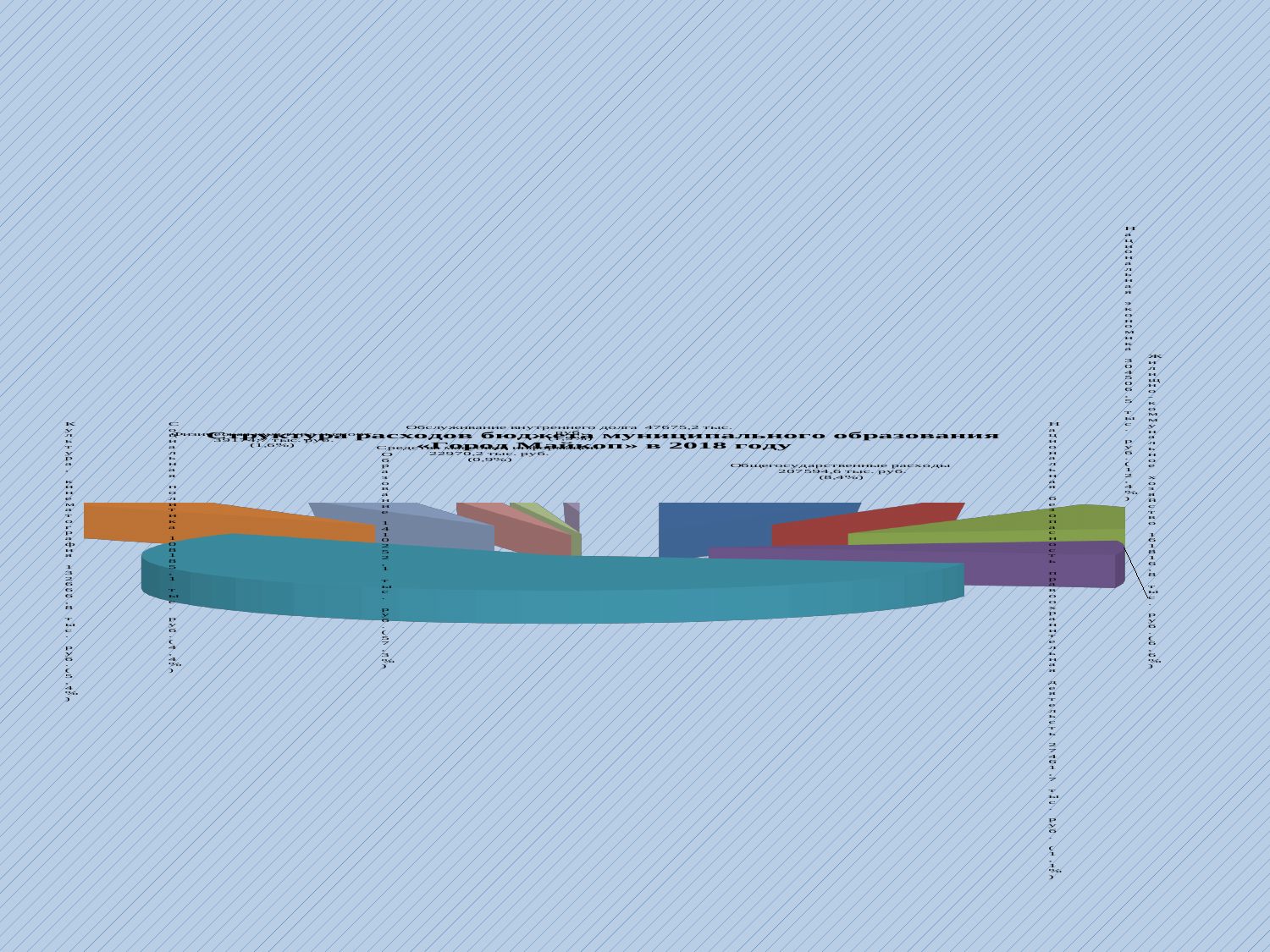
Which is larger, the share for Общегосударственные расходы or the share for Средства массовой информации? Общегосударственные расходы What is the title of the chart? Структура расходов бюджета муниципального образования «Город Майкоп» в 2018 году What share of the pie does Образование take? 57,3% What is the value shown for Средства массовой информации? 22970,2 тыс. руб. What share of the pie does Общегосударственные расходы take? 8,4% Which category has the largest slice of the pie? Образование What kind of chart is shown on the slide? pie chart What is the value shown for Общегосударственные расходы? 207594,6 тыс. руб. Which is larger, the slice for Образование or the slice for Общегосударственные расходы? Образование What share of the pie does Средства массовой информации take? 0,9% What is the value shown for Обслуживание внутреннего долга? 47675,2 тыс. руб.